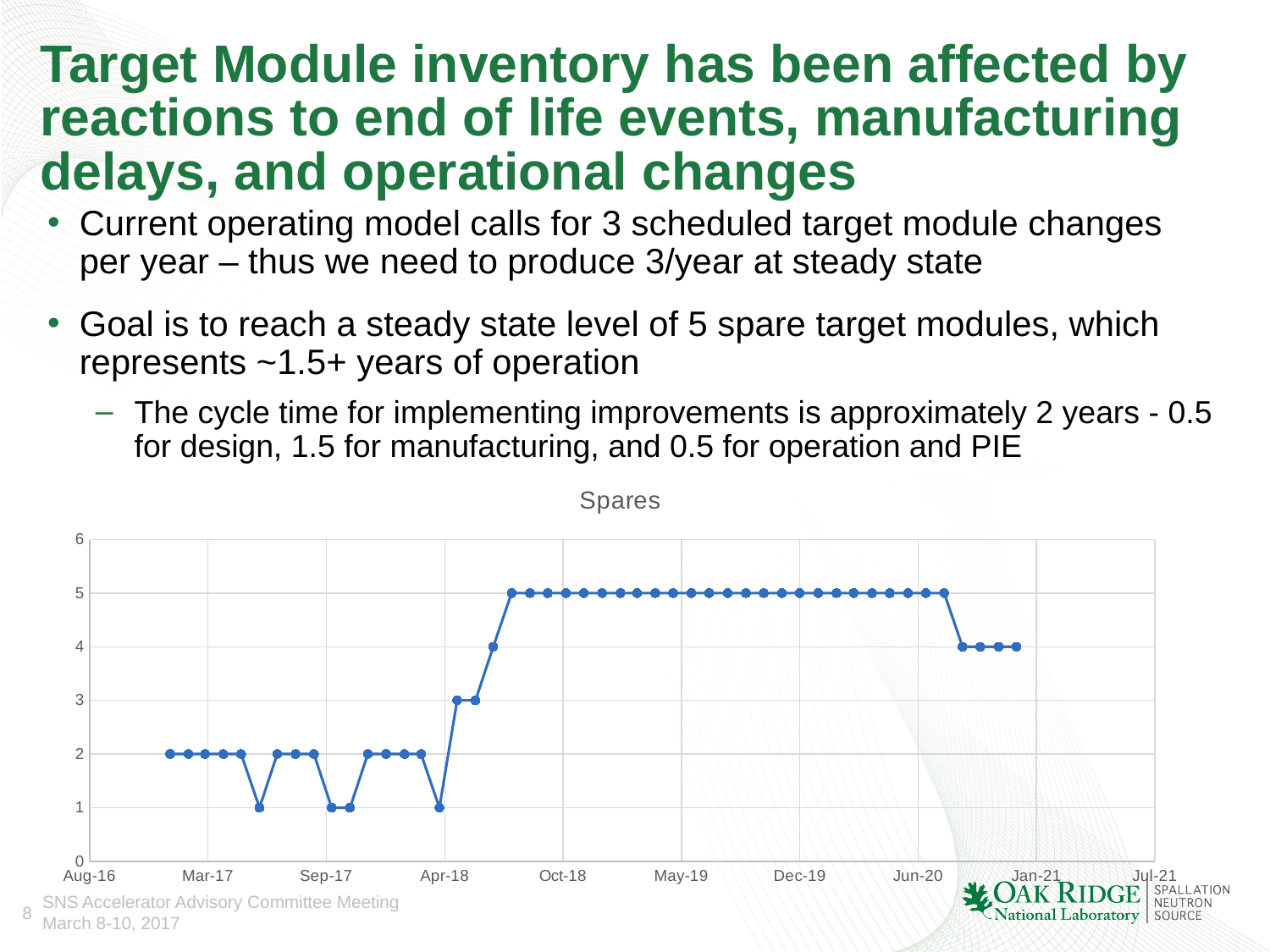
What is the value of Spares at Oct-18? 5 Overall, does the Spares line rise or fall from Aug-16 to Jul-21? rise What kind of chart is shown on the slide? line chart What is the highest tick shown on the y axis of the Spares chart? 6 What is the title of the chart? Spares What is the value of Spares at Jun-20? 5 What is the lowest value reached by the line in the Spares chart? 1 Is the value of Spares at Mar-17 greater or less than 3? less What is the highest value reached by the line in the Spares chart? 5